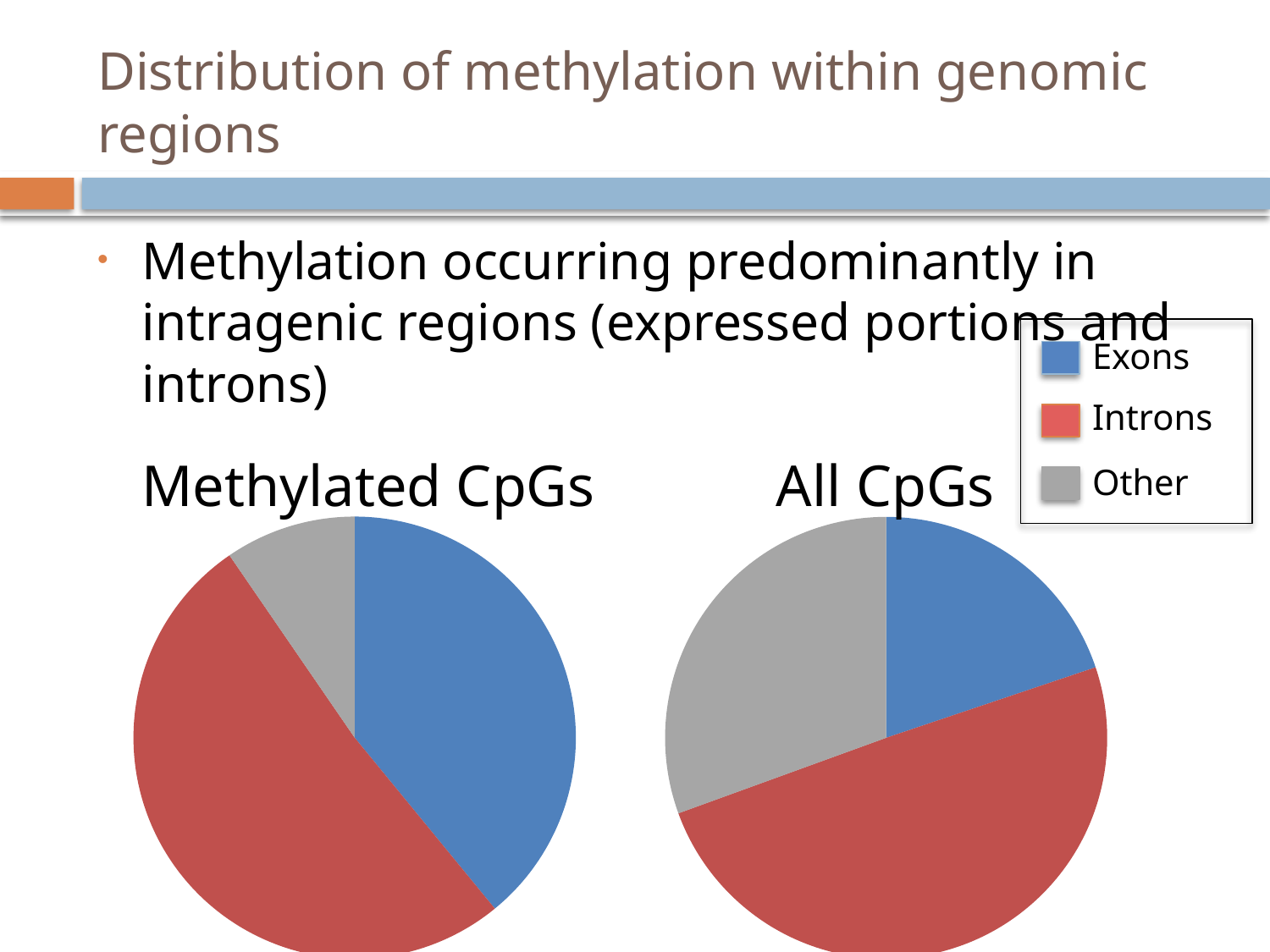
Which colour represents Introns in the pie charts? red In the "All CpGs" pie chart, which category has the largest slice? Introns In the "Methylated CpGs" pie chart, which slice is larger, Exons or Other? Exons In the "Methylated CpGs" pie chart, which category has the largest slice? Introns How many entries does the legend list for the pie charts? 3 What are the titles of the two pie charts on the slide? Methylated CpGs and All CpGs In the "All CpGs" pie chart, which slice is larger, Exons or Other? Other How many slices does the "Methylated CpGs" pie chart have? 3 In the "Methylated CpGs" pie chart, which category has the smallest slice? Other In the "All CpGs" pie chart, which category has the smallest slice? Exons What kind of chart is the "Methylated CpGs" chart? pie chart What kind of chart is the "All CpGs" chart? pie chart